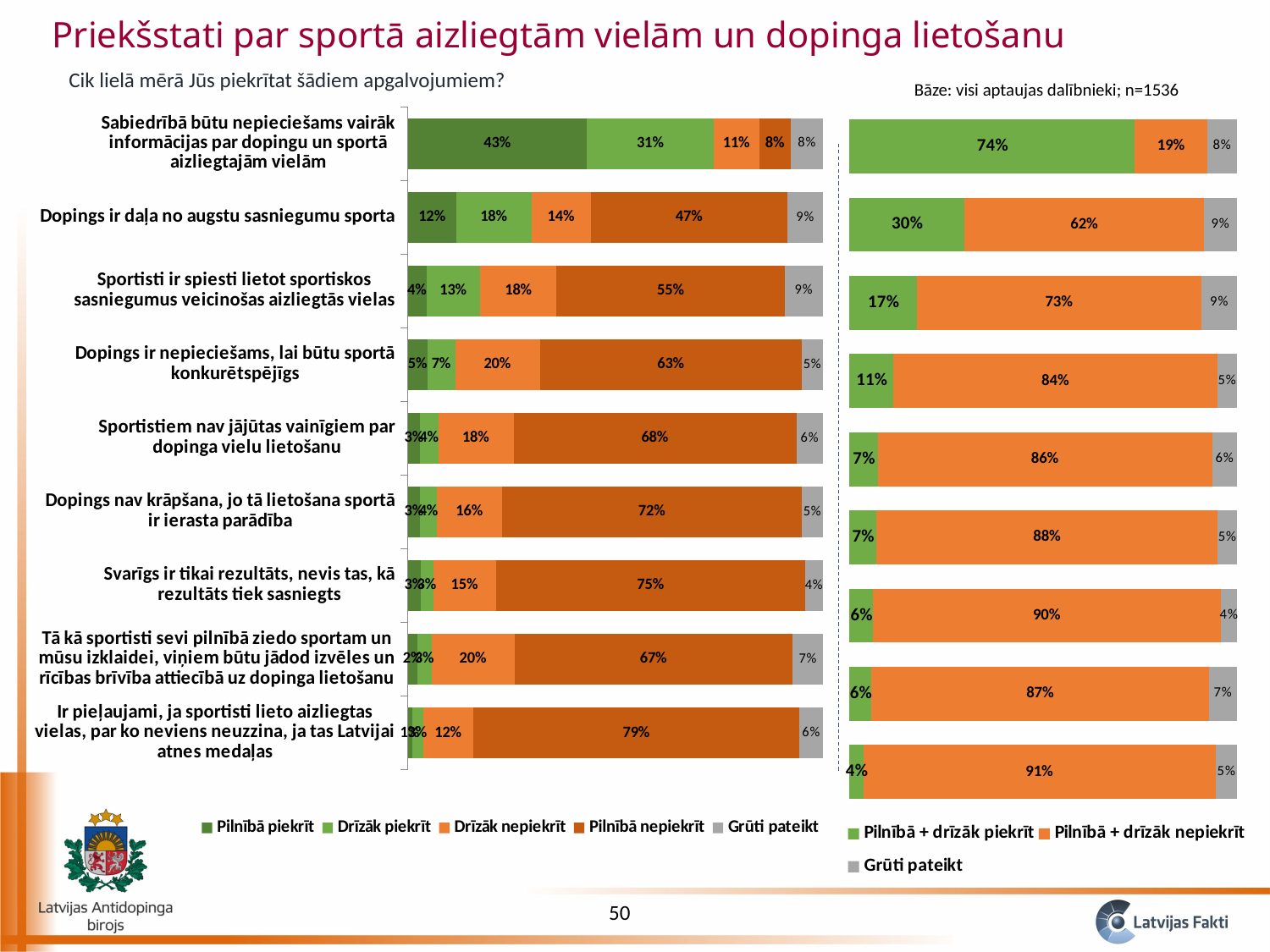
In the right chart, for "Sabiedrībā būtu nepieciešams vairāk informācijas par dopingu un sportā aizliegtajām vielām", how many percentage points larger is "Pilnībā + drīzāk piekrīt" than "Pilnībā + drīzāk nepiekrīt"? 55 percentage points How many series does the legend of the left chart list? 5 In the left chart, what is the "Pilnībā nepiekrīt" value for "Dopings ir daļa no augstu sasniegumu sporta"? 47% In the left chart, which statement has the larger "Drīzāk nepiekrīt" value: "Dopings ir daļa no augstu sasniegumu sporta" or "Sportisti ir spiesti lietot sportiskos sasniegumus veicinošas aizliegtās vielas"? Sportisti ir spiesti lietot sportiskos sasniegumus veicinošas aizliegtās vielas (18%) In the right chart, what is the "Pilnībā + drīzāk piekrīt" value for "Dopings ir nepieciešams, lai būtu sportā konkurētspējīgs"? 11% What kind of chart is the left chart? Stacked horizontal bar chart How many series does the legend of the right chart list? 3 In the right chart, which statement has the highest "Pilnībā + drīzāk piekrīt" value? Sabiedrībā būtu nepieciešams vairāk informācijas par dopingu un sportā aizliegtajām vielām (74%) What is the base (number of respondents) stated on the slide? n=1536 In the right chart, which statement has the highest "Pilnībā + drīzāk nepiekrīt" value? Ir pieļaujami, ja sportisti lieto aizliegtas vielas, par ko neviens neuzzina, ja tas Latvijai atnes medaļas (91%) In the left chart, what percentage of respondents answered "Pilnībā piekrīt" to the statement "Sabiedrībā būtu nepieciešams vairāk informācijas par dopingu un sportā aizliegtajām vielām"? 43% How many statements (categories) are shown in the left chart? 9